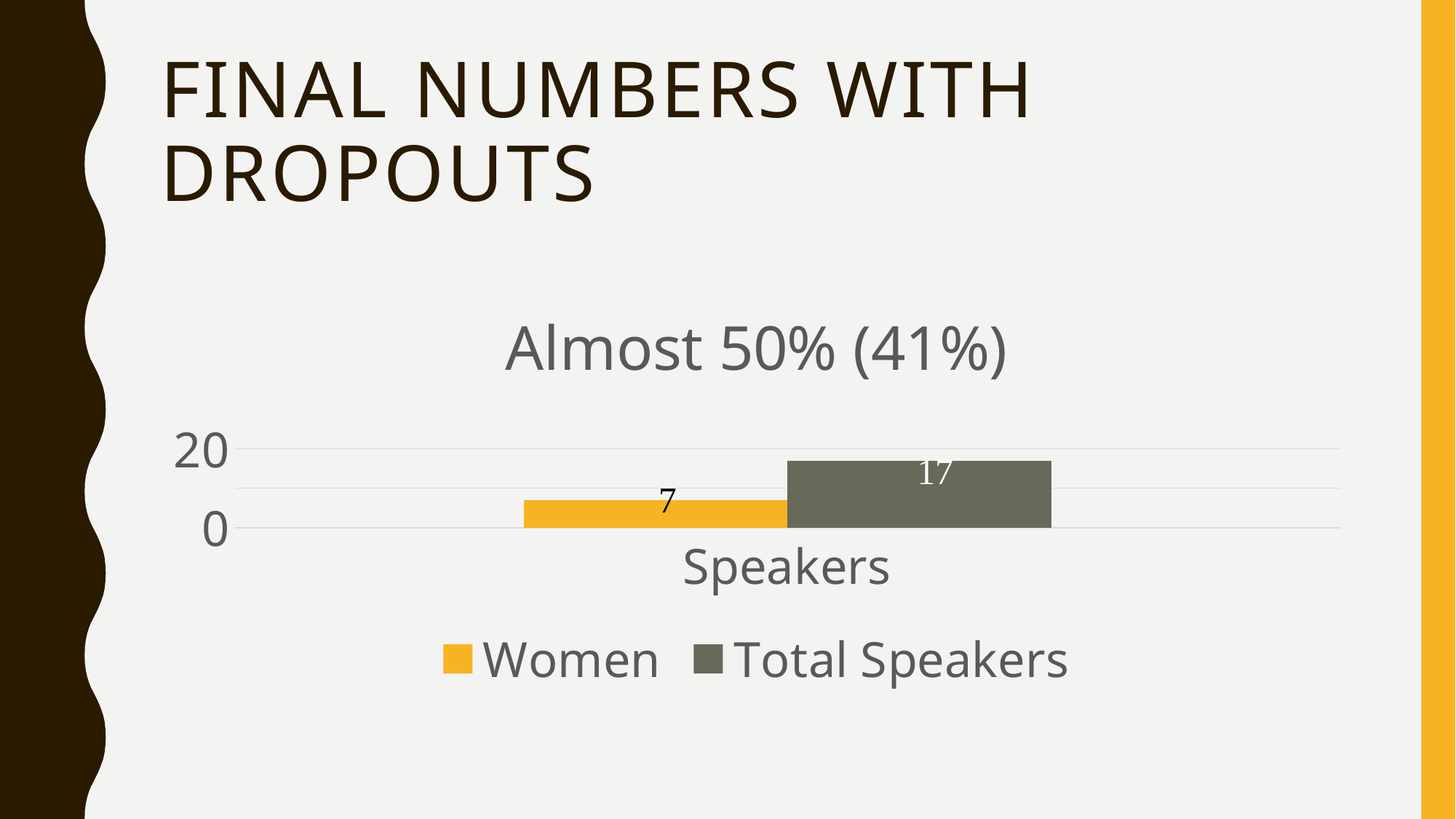
What is the title of the chart? Almost 50% (41%) What kind of chart is shown on the slide? bar chart Is the value for Total Speakers greater or less than 20? less How many series does the legend list? 2 What is the value for Total Speakers in the Speakers category? 17 How many categories are shown on the x axis? 1 What is the value for Women in the Speakers category? 7 Which series has the higher value for Speakers, Women or Total Speakers? Total Speakers What is the label of the category on the x axis? Speakers Which series is shown in yellow? Women What is the difference between Total Speakers and Women for the Speakers category? 10